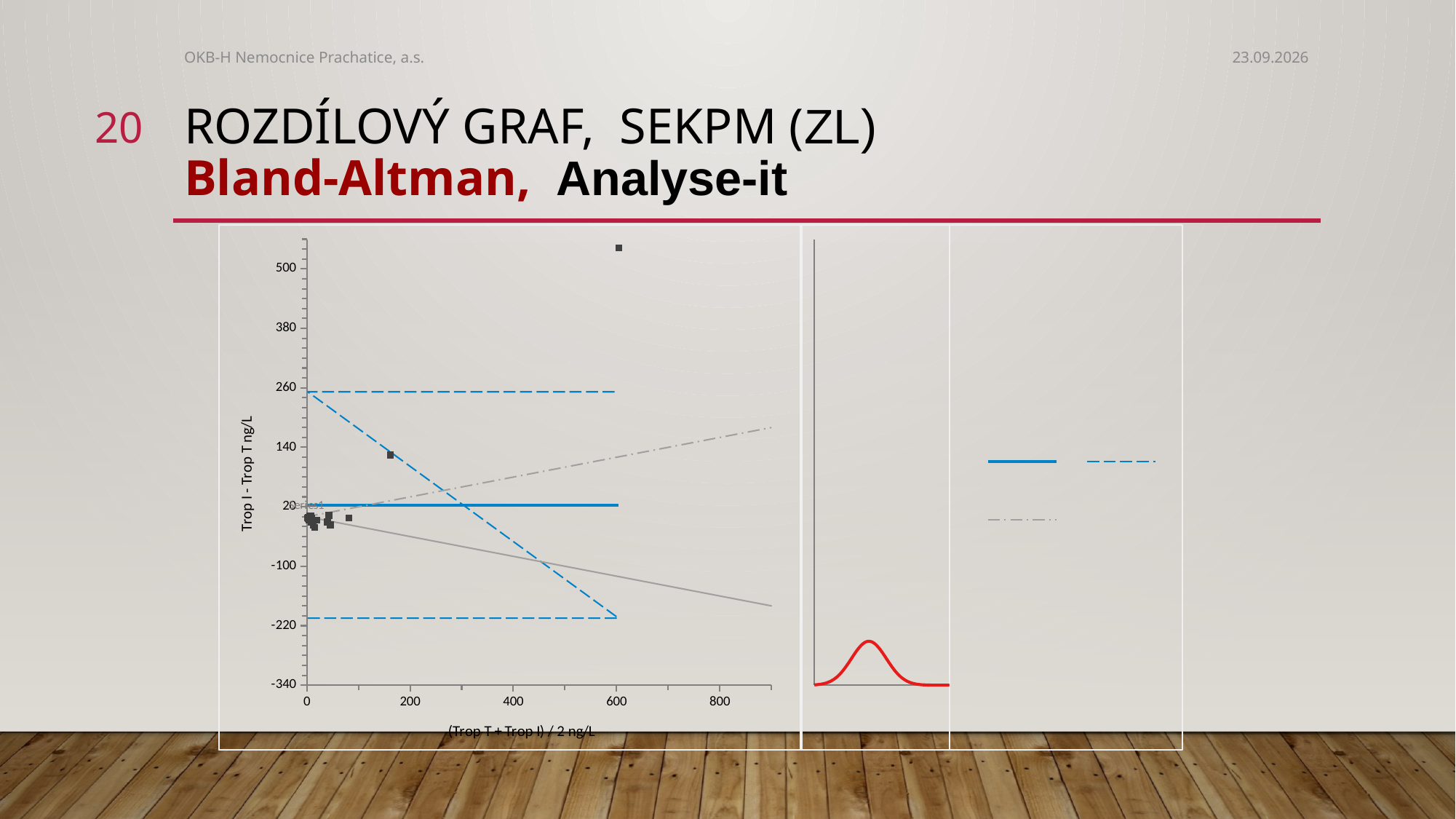
What is the label of the vertical axis of the scatter chart? Trop I - Trop T ng/L What is the label of the horizontal axis of the scatter chart? (Trop T + Trop I) / 2 ng/L What kind of chart is the main chart on the left of the slide? scatter chart What is the highest tick value shown on the vertical axis of the scatter chart? 500 In the scatter chart, is the value of the isolated point near x = 160 greater or less than 140? less In the scatter chart, is the value of the highest plotted point greater or less than 500? greater In the scatter chart, is the lower dashed blue horizontal line above or below -220 on the vertical axis? above